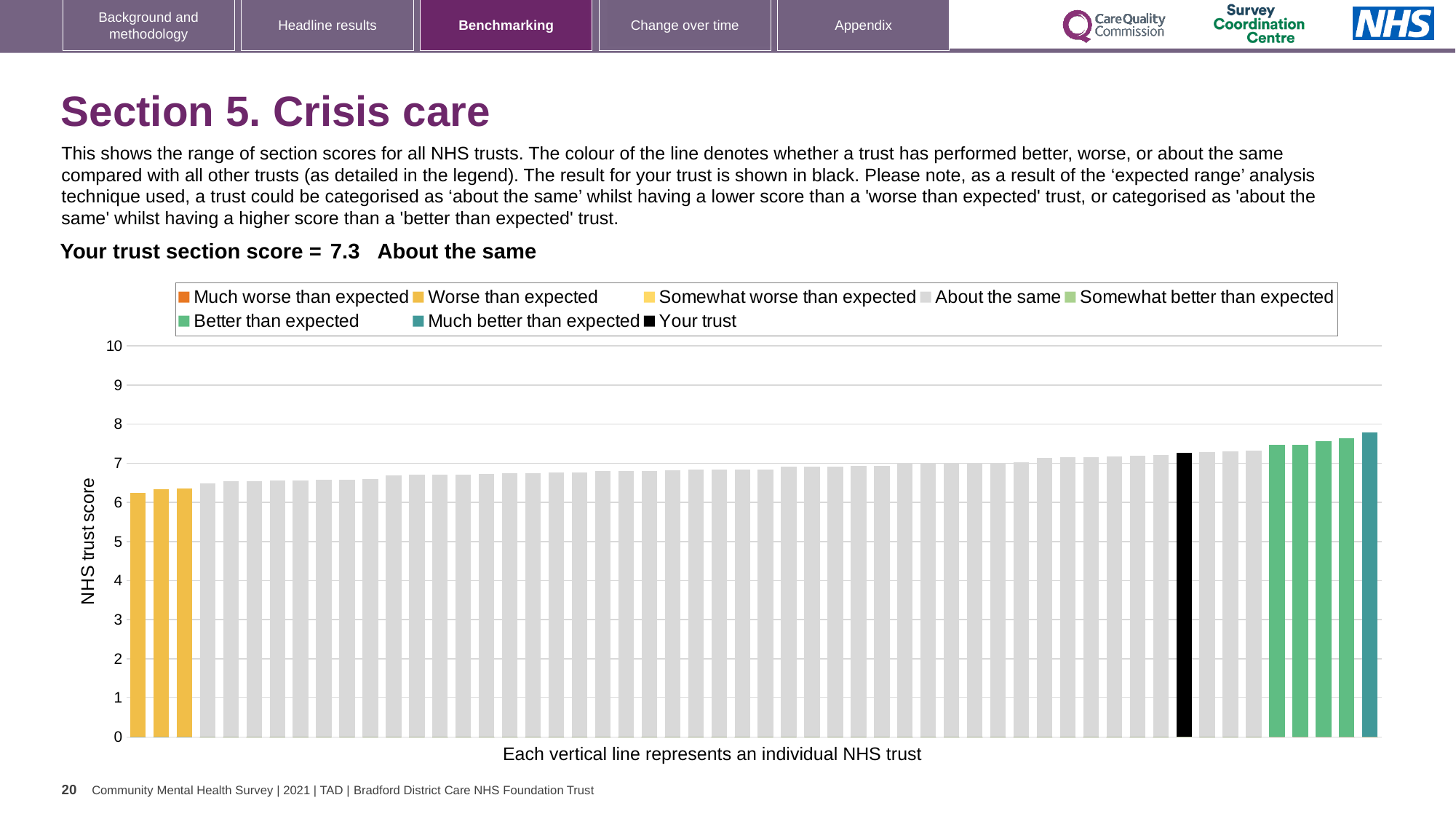
How many bars are coloured as 'Worse than expected' (yellow)? 3 Do the bar values rise or fall from left to right along the x axis? rise Is the value of the tallest bar greater or less than 8? less How many bars are coloured as 'Better than expected' (green)? 4 What colour is the bar representing your trust? black What kind of chart is shown on the slide? bar chart How many entries does the chart legend list? 8 Is the value of the leftmost bar greater or less than 7? less Is the value for your trust (the black bar) greater or less than 7? greater Which legend category does the tallest bar belong to? Much better than expected What is the section score for your trust shown on the slide? 7.3 What is the label on the vertical axis of the chart? NHS trust score